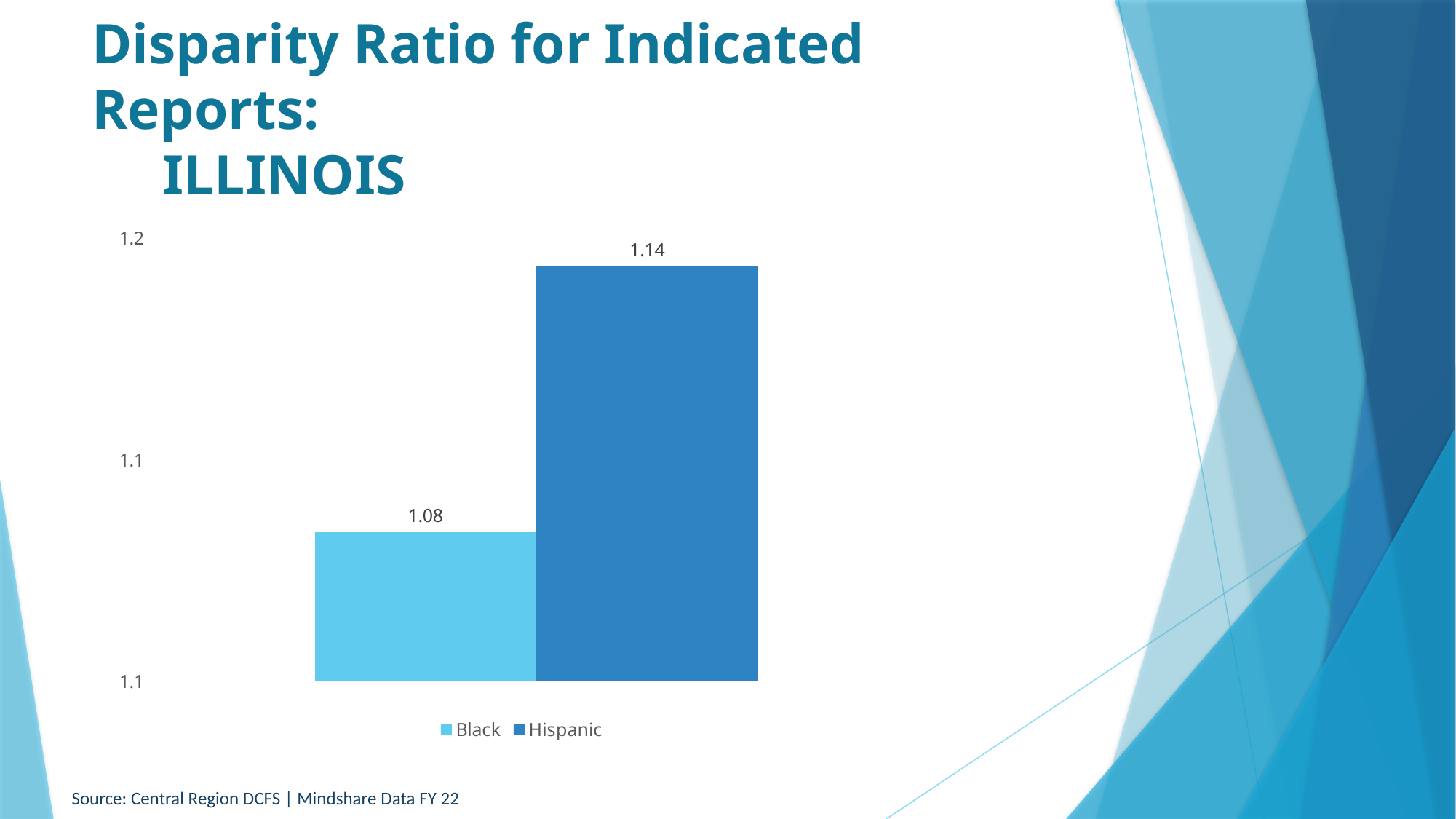
What kind of chart is shown on the slide? bar chart Is the value for Black greater or less than 1.1? less What is the difference between the Hispanic and Black disparity ratios? 0.06 How many bars are plotted in the chart? 2 Which group has the lower disparity ratio? Black What is the title of the slide? Disparity Ratio for Indicated Reports: ILLINOIS How many entries does the legend list? 2 What is the disparity ratio for Hispanic? 1.14 Is the disparity ratio for Black larger or smaller than the ratio for Hispanic? smaller What is the disparity ratio for Black? 1.08 Is the value for Hispanic greater or less than 1.1? greater Which group has the higher disparity ratio? Hispanic